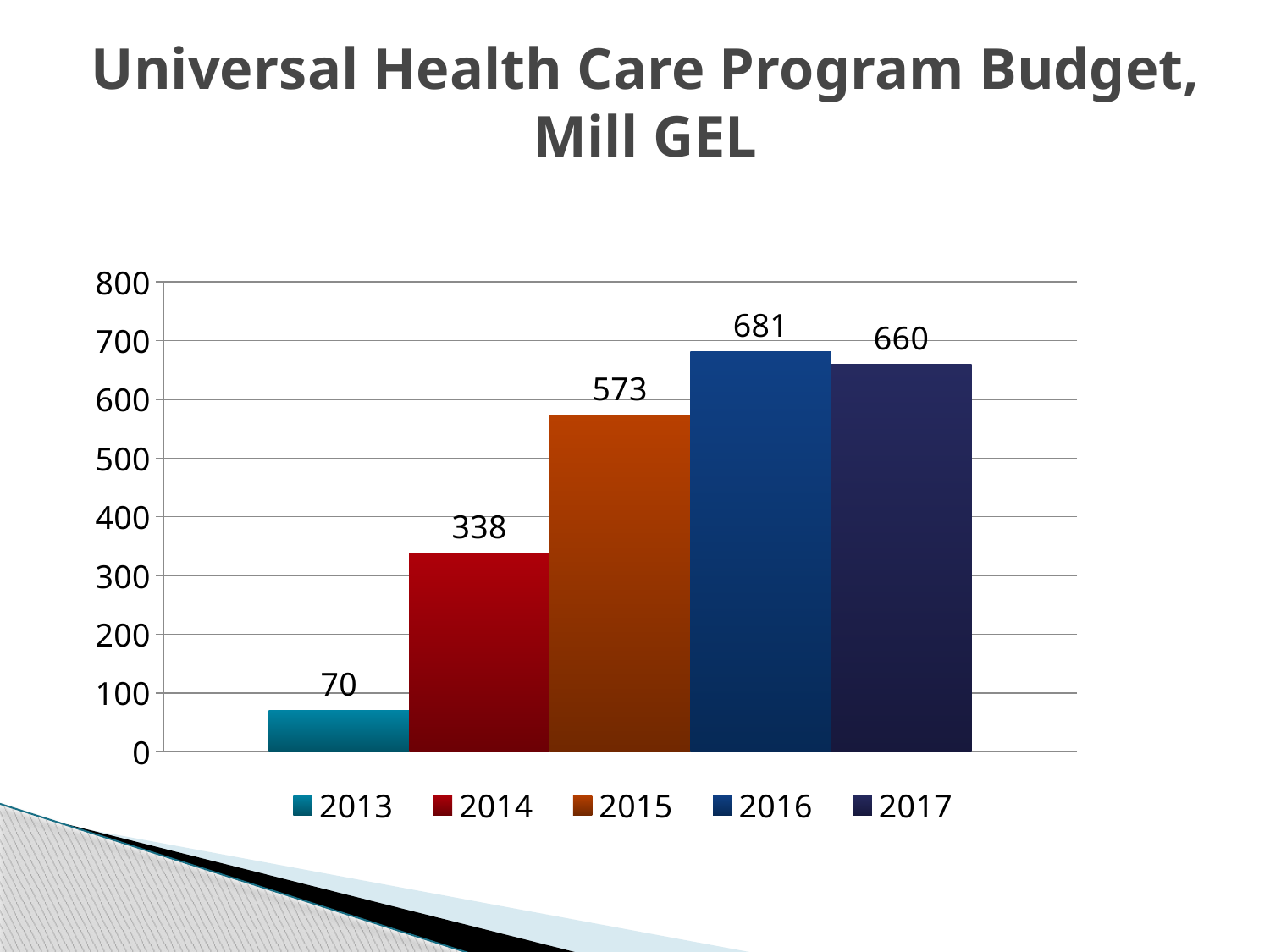
Which year has the lowest budget? 2013 What is the budget value for 2015? 573 What kind of chart is shown on the slide? bar chart What is the budget value for 2017? 660 What is the difference between the 2014 and 2013 budgets? 268 Which is larger, the budget for 2015 or for 2017? 2017 What is the budget value for 2013? 70 What is the difference between the 2016 and 2017 budgets? 21 How many years are shown in the chart? 5 Which year has the highest budget? 2016 What is the title of the chart? Universal Health Care Program Budget, Mill GEL Is the value for 2014 greater or less than 300? greater